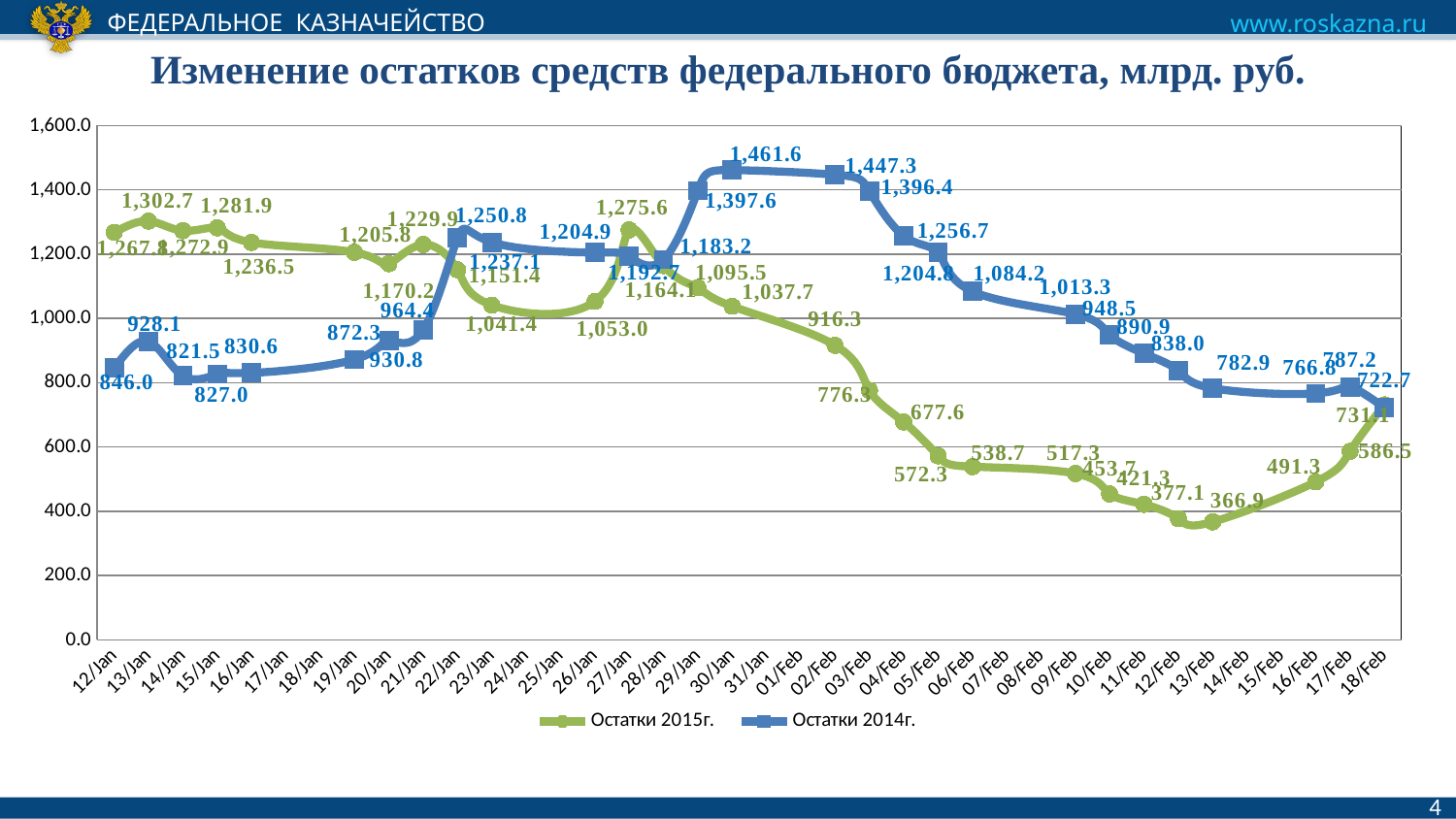
Does the Остатки 2015г. series rise or fall between 01/Feb and 13/Feb? Fall What is the difference between the Остатки 2014г. and Остатки 2015г. values on 18/Feb? 8.4 How many series does the legend list? 2 What kind of chart is shown on the slide? Line chart What is the highest value of the Остатки 2015г. series? 1,302.7 What is the lowest value of the Остатки 2015г. series? 366.9 What is the highest value reached by the Остатки 2014г. series? 1,461.6 What is the value of Остатки 2014г. on 12/Jan? 846.0 What is the value of Остатки 2015г. on 18/Feb? 731.1 On 18/Feb, which series has the larger value, Остатки 2015г. or Остатки 2014г.? Остатки 2015г. What are the two series named in the legend? Остатки 2015г. and Остатки 2014г.